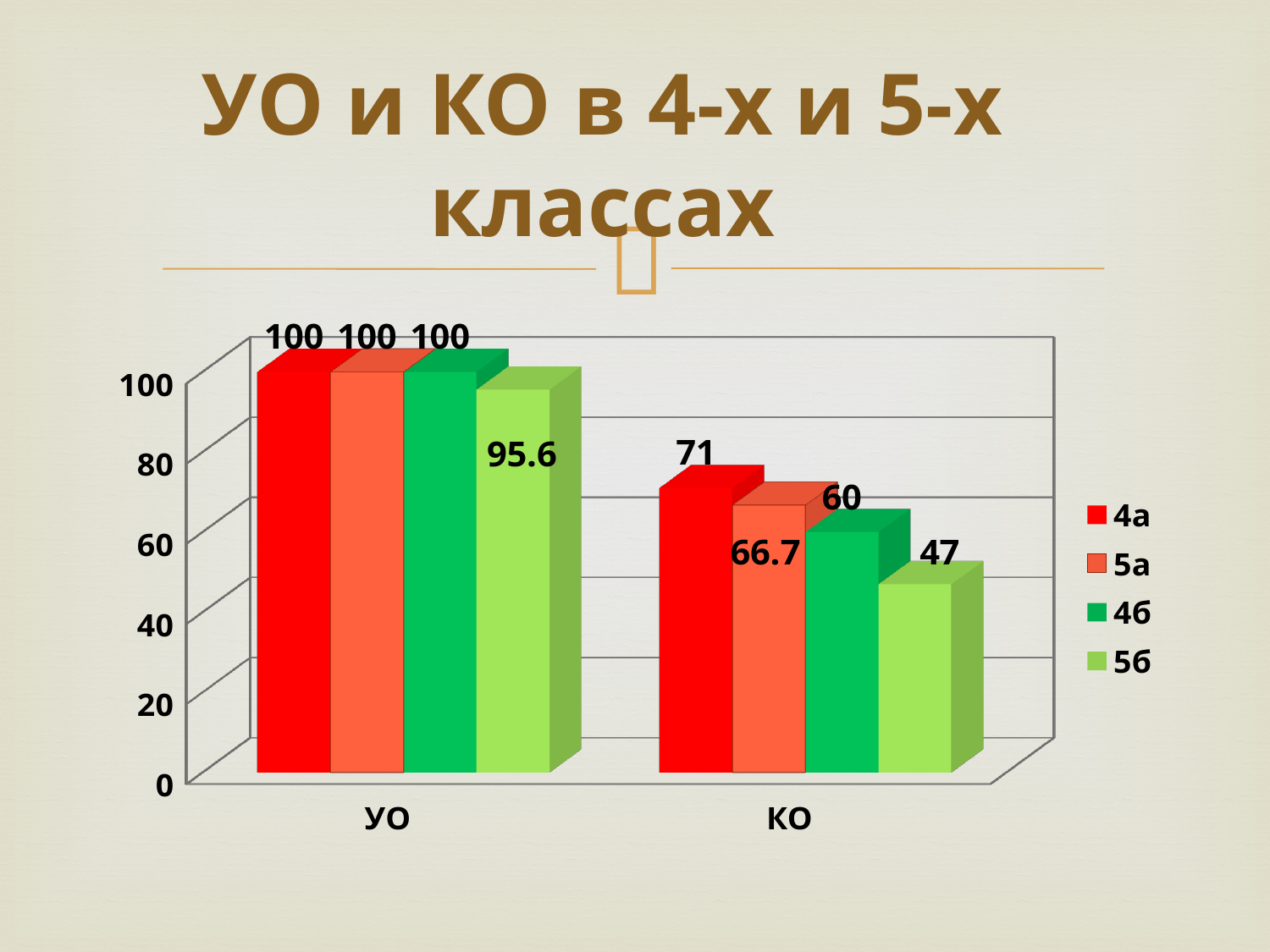
Which is larger in the КО category, the value for 5а or the value for 4б? 5а Which series has the highest value in the КО category? 4а What is the value for 4а in the КО category? 71 Which series has the lowest value in the КО category? 5б How many series does the legend list? 4 What is the difference between the 4а and 5б values in the КО category? 24 What is the value for 5а in the КО category? 66.7 How many categories are shown on the x axis? 2 What is the title of the slide? УО и КО в 4-х и 5-х классах What is the value for 5б in the УО category? 95.6 What type of chart is shown on the slide? bar chart What is the value for 4б in the КО category? 60